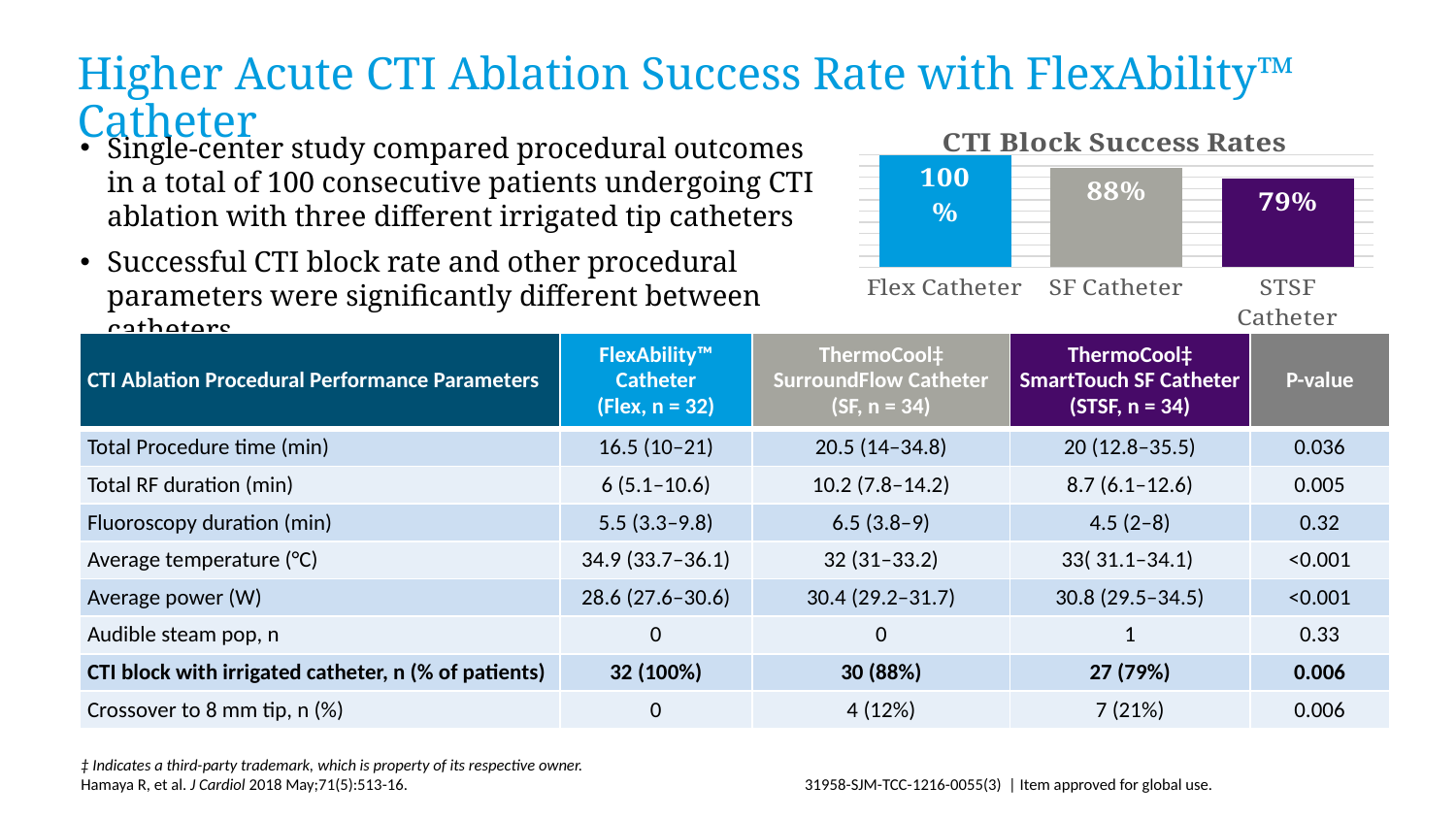
How many catheters are shown in the CTI Block Success Rates chart? 3 What is the title of the chart on the slide? CTI Block Success Rates What is the difference in success rate between the SF Catheter and the STSF Catheter in the chart? 9% In the CTI Block Success Rates chart, which has a higher success rate, the SF Catheter or the STSF Catheter? SF Catheter In the CTI Block Success Rates chart, what is the success rate for the STSF Catheter? 79% Do the success rates in the CTI Block Success Rates chart rise or fall from left to right? fall In the CTI Block Success Rates chart, what is the success rate for the SF Catheter? 88% What is the difference in success rate between the Flex Catheter and the SF Catheter in the chart? 12% What kind of chart is shown on the slide? bar chart Which catheter has the highest CTI block success rate in the chart? Flex Catheter Which catheter has the lowest CTI block success rate in the chart? STSF Catheter In the CTI Block Success Rates chart, what is the success rate for the Flex Catheter? 100%